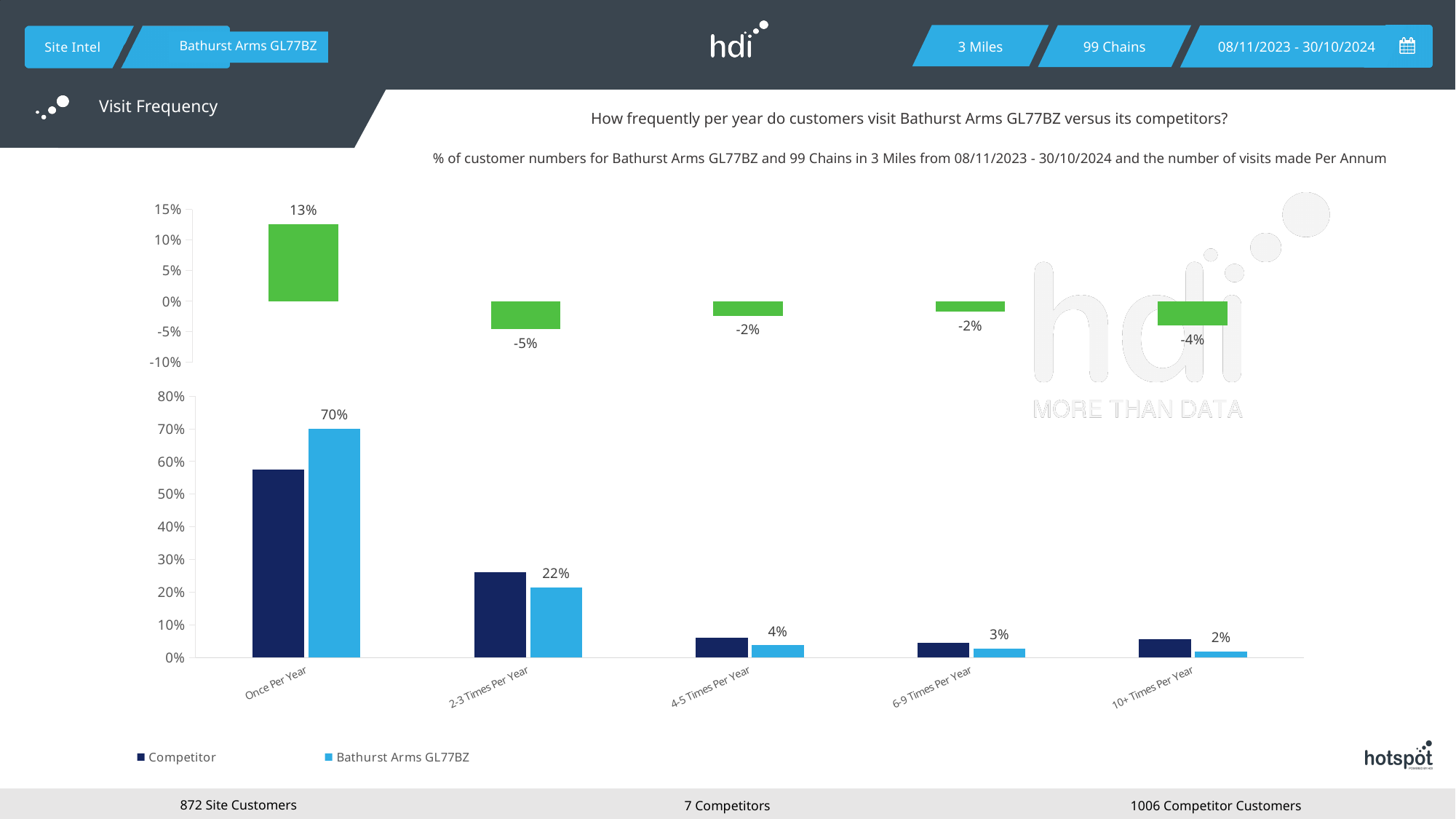
In the top chart, what is the value shown for 2-3 Times Per Year? -5% What kind of chart is the bottom chart? bar chart In the bottom chart, for Once Per Year, which series has the larger value: Competitor or Bathurst Arms GL77BZ? Bathurst Arms GL77BZ In the top chart, which category has the highest value? Once Per Year In the bottom chart, what is the value for Bathurst Arms GL77BZ in the Once Per Year category? 70% In the bottom chart, what is the value for Bathurst Arms GL77BZ in the 2-3 Times Per Year category? 22% How many visit frequency categories are shown on the x axis of the bottom chart? 5 In the bottom chart, is the Competitor value for Once Per Year greater or less than 50%? greater In the top chart, what is the value shown for Once Per Year? 13% In the bottom chart, what is the difference between the Bathurst Arms GL77BZ values for Once Per Year and 2-3 Times Per Year? 48% In the top chart, which category has the lowest value? 2-3 Times Per Year How many series does the legend of the bottom chart list? 2